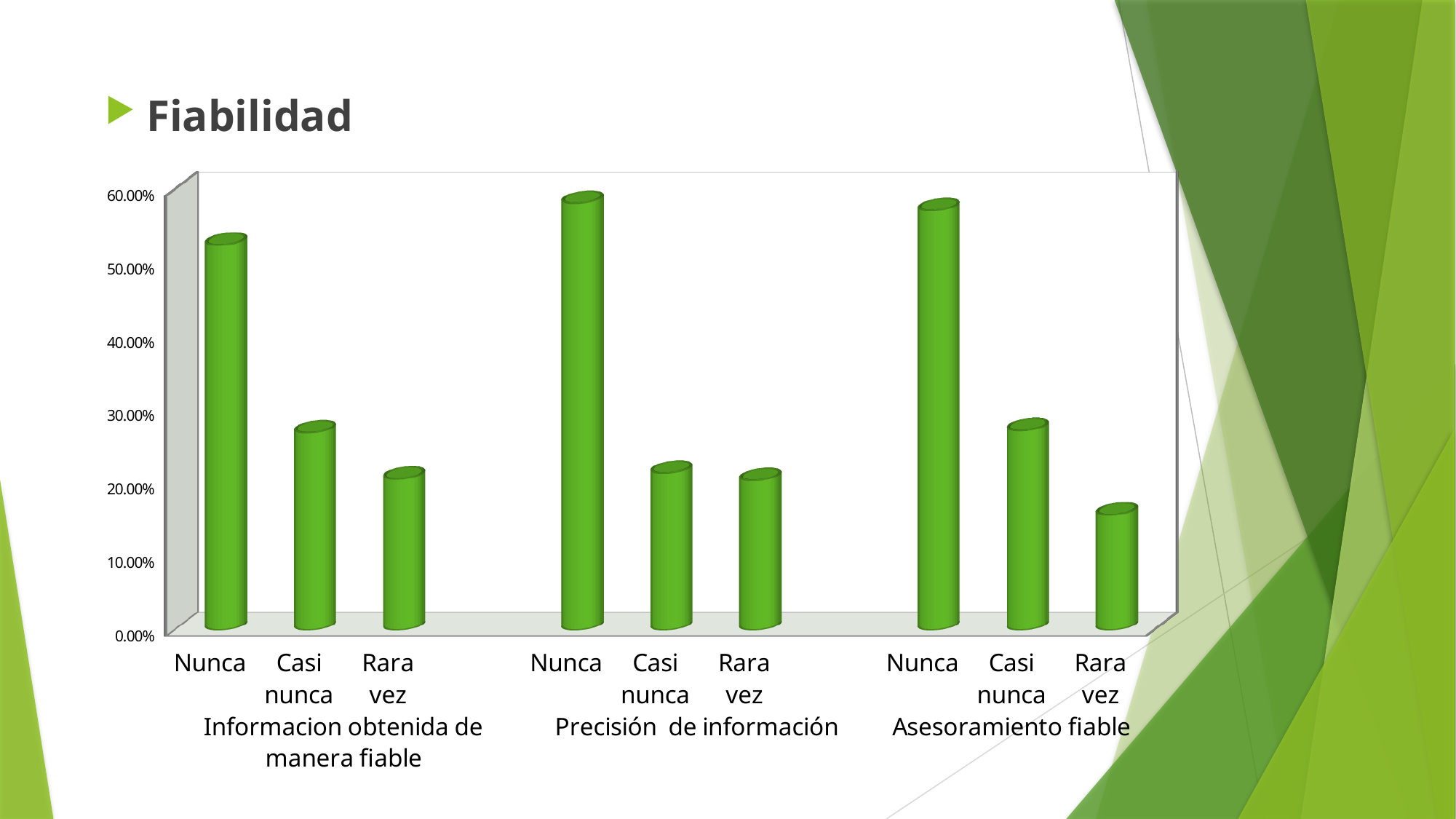
Which response has the highest value in the Asesoramiento fiable group? Nunca What is the title of the slide containing the chart? Fiabilidad How many bars are plotted in the chart? 9 Is the value for Rara vez in the Asesoramiento fiable group greater or less than 20.00%? less How many category groups are shown along the x axis? 3 Which is larger: the Nunca value for Informacion obtenida de manera fiable or the Nunca value for Precisión de información? Precisión de información Is the value for Casi nunca in the Informacion obtenida de manera fiable group greater or less than 30.00%? less Which bar has the lowest value in the whole chart? Rara vez in Asesoramiento fiable Is the value for Nunca in the Precisión de información group greater or less than 50.00%? greater What kind of chart is shown on the slide? bar chart